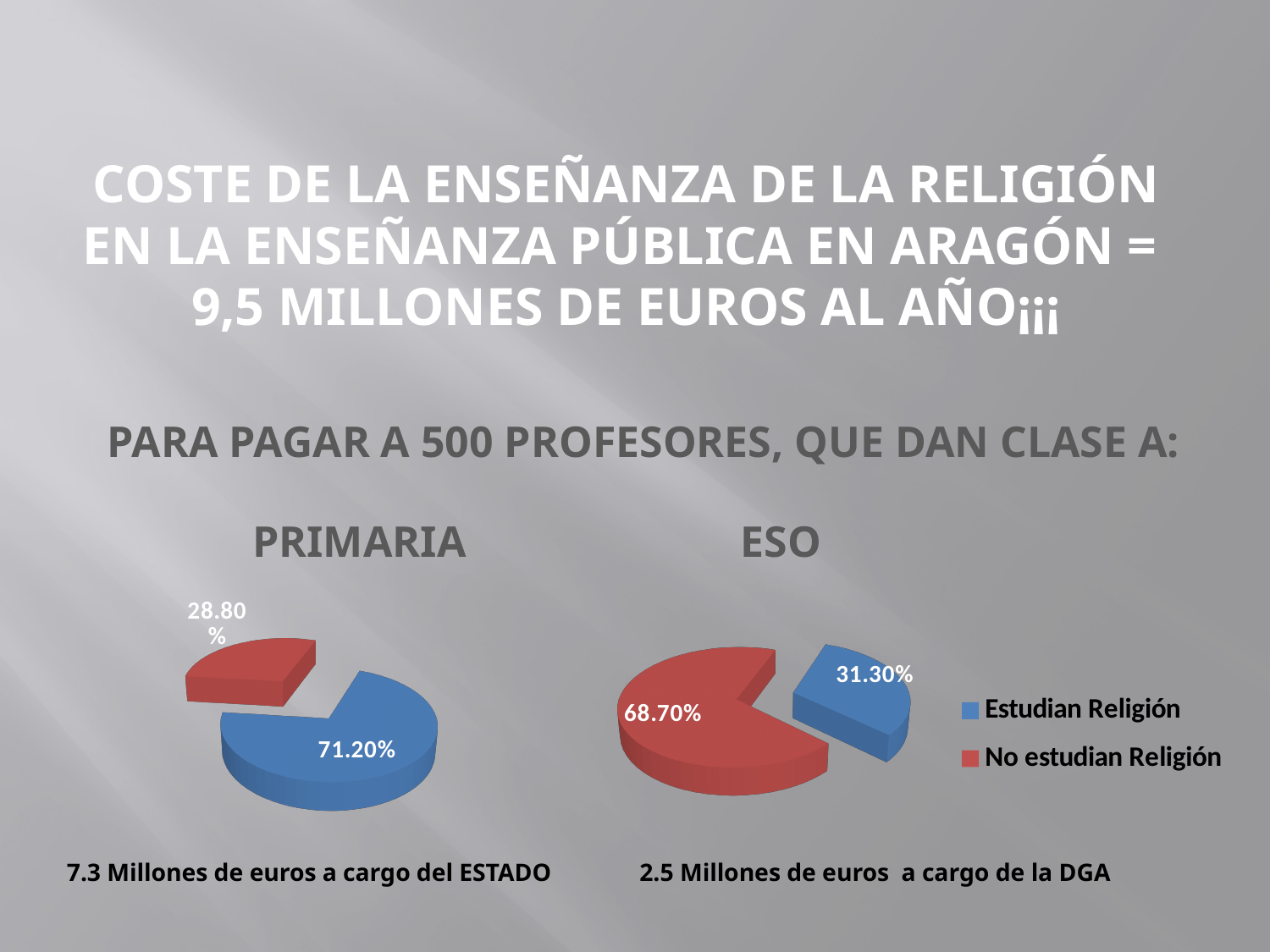
What type of chart is used for PRIMARIA and ESO? Pie chart In the PRIMARIA pie chart, what is the difference between the Estudian Religión and No estudian Religión shares? 42.40% Which is larger: the Estudian Religión share in the PRIMARIA chart or the Estudian Religión share in the ESO chart? PRIMARIA In the ESO pie chart, which slice is the smallest? Estudian Religión In the ESO pie chart, what percentage of students study religion (Estudian Religión)? 31.30% In the PRIMARIA pie chart, what percentage of students study religion (Estudian Religión)? 71.20% How many categories does the legend list for the pie charts? 2 In the ESO pie chart, what is the difference between the No estudian Religión and Estudian Religión shares? 37.40% In the legend, which colour represents No estudian Religión? Red In the ESO pie chart, what percentage of students do not study religion (No estudian Religión)? 68.70% In the PRIMARIA pie chart, which slice is the largest? Estudian Religión In the PRIMARIA pie chart, what percentage of students do not study religion (No estudian Religión)? 28.80%